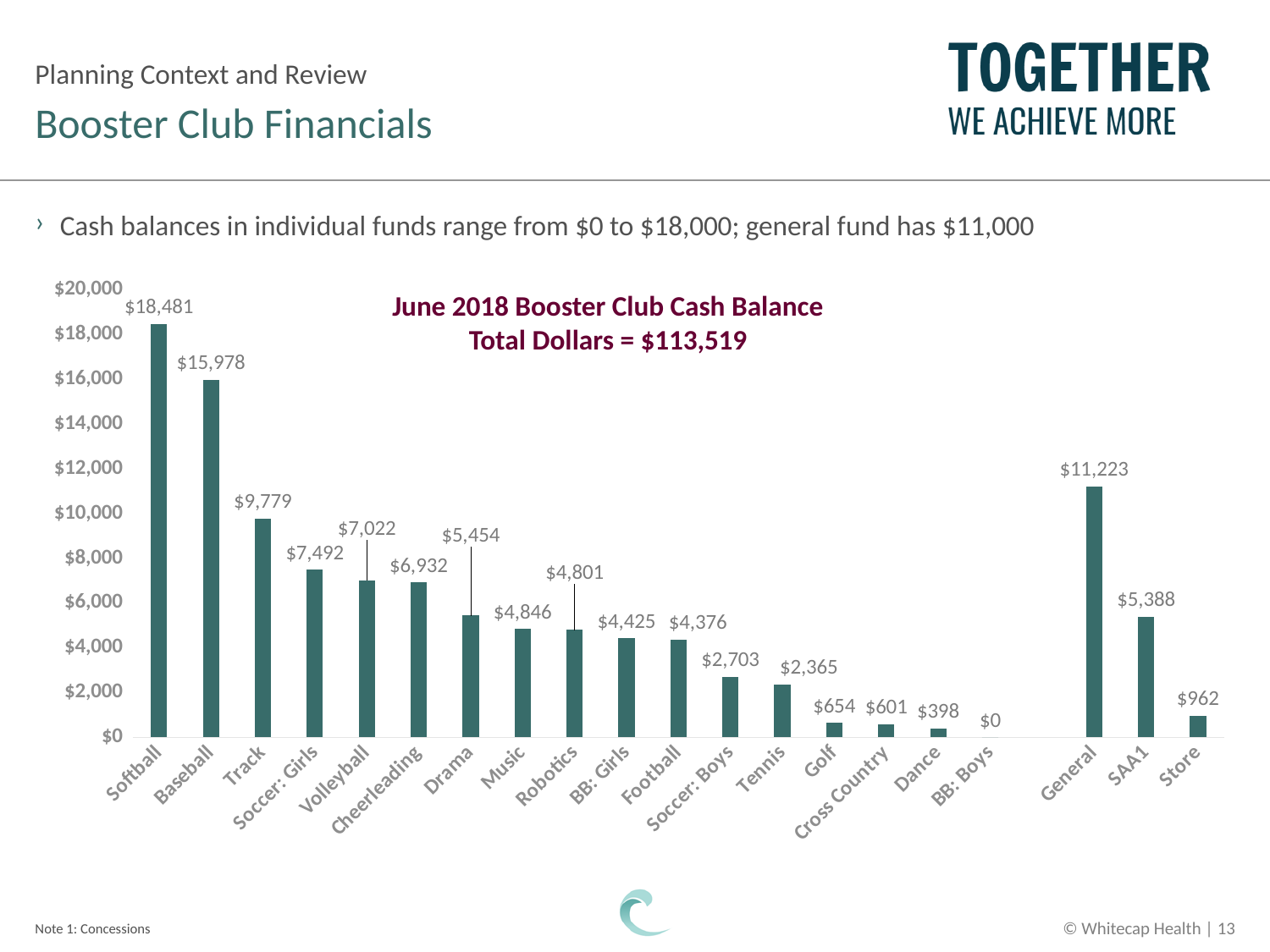
What is the total dollar amount stated in the chart title? $113,519 Which has a larger cash balance, Track or General? General What is the cash balance for the General fund? $11,223 What is the cash balance for Softball? $18,481 Is the cash balance for Baseball greater or less than $14,000? greater Which fund has the lowest cash balance? BB: Boys How many funds are shown on the chart? 20 What is the difference between the Softball and Baseball cash balances? $2,503 What is the cash balance for Tennis? $2,365 Which fund has the highest cash balance? Softball What is the cash balance for Cross Country? $601 What type of chart is shown on the slide? Bar chart